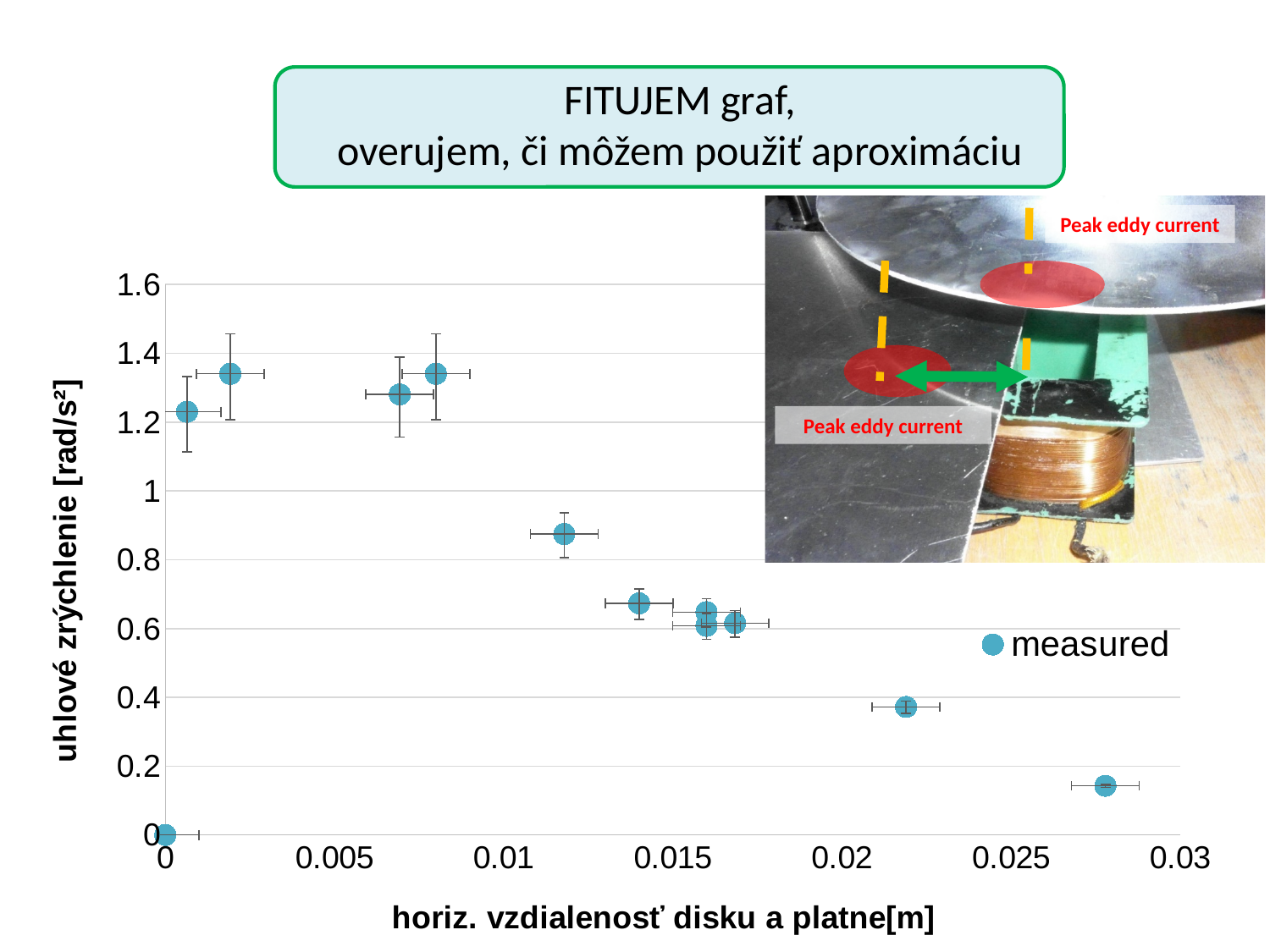
Do the measured values generally rise or fall as the horizontal distance increases along the x axis? fall What kind of chart is shown on the slide? scatter chart What is the angular acceleration value of the measured point at horizontal distance 0 m? 0 Which has the larger angular acceleration: the measured point near 0.007 m or the measured point near 0.014 m? the point near 0.007 m What is the title of the vertical axis of the chart? uhlové zrýchlenie [rad/s²] Which has the larger angular acceleration: the measured point near 0.012 m or the measured point near 0.022 m? the point near 0.012 m Which measured point has the lowest angular acceleration value? the point at horizontal distance 0 Is the angular acceleration of the measured point near horizontal distance 0.028 m greater or less than 0.2? less How many series does the chart legend list? 1 Is the angular acceleration of the measured point near horizontal distance 0.002 m greater or less than 1.2? greater Is the angular acceleration of the measured point near horizontal distance 0.012 m greater or less than 0.8? greater What is the name of the series shown in the chart legend? measured